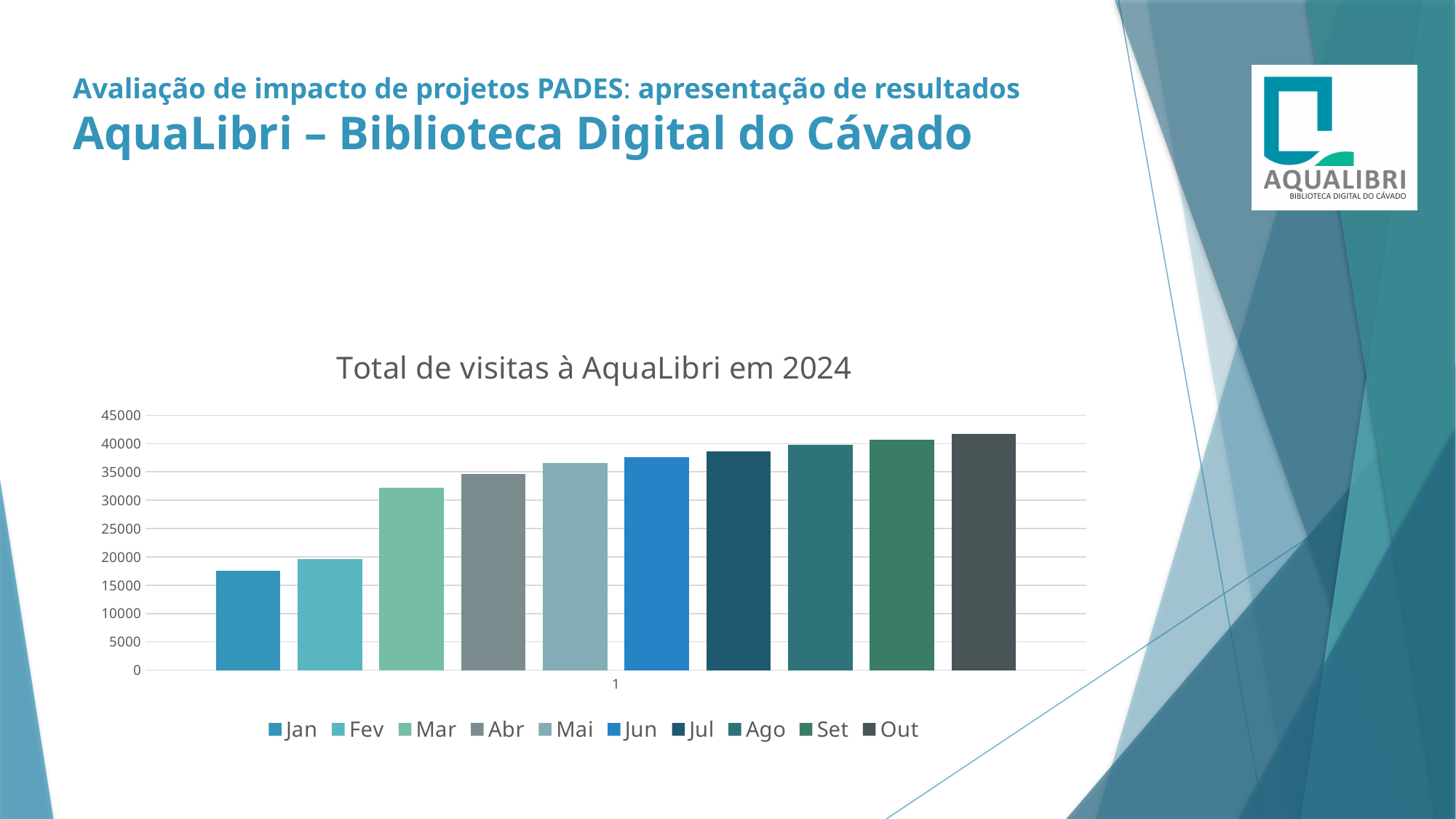
How many series does the chart legend list? 10 Is the value for Mar greater or less than 30000? greater Which is larger, the value for Jan or the value for Out? Out Is the value for Jan greater or less than 20000? less Is the value for Jun greater or less than 35000? greater Which is larger, the value for Fev or the value for Mar? Mar What kind of chart is shown on the slide? bar chart What is the title of the chart? Total de visitas à AquaLibri em 2024 Which month has the lowest number of visits? Jan Which month has the highest number of visits? Out Do the values rise or fall from Jan to Out? rise